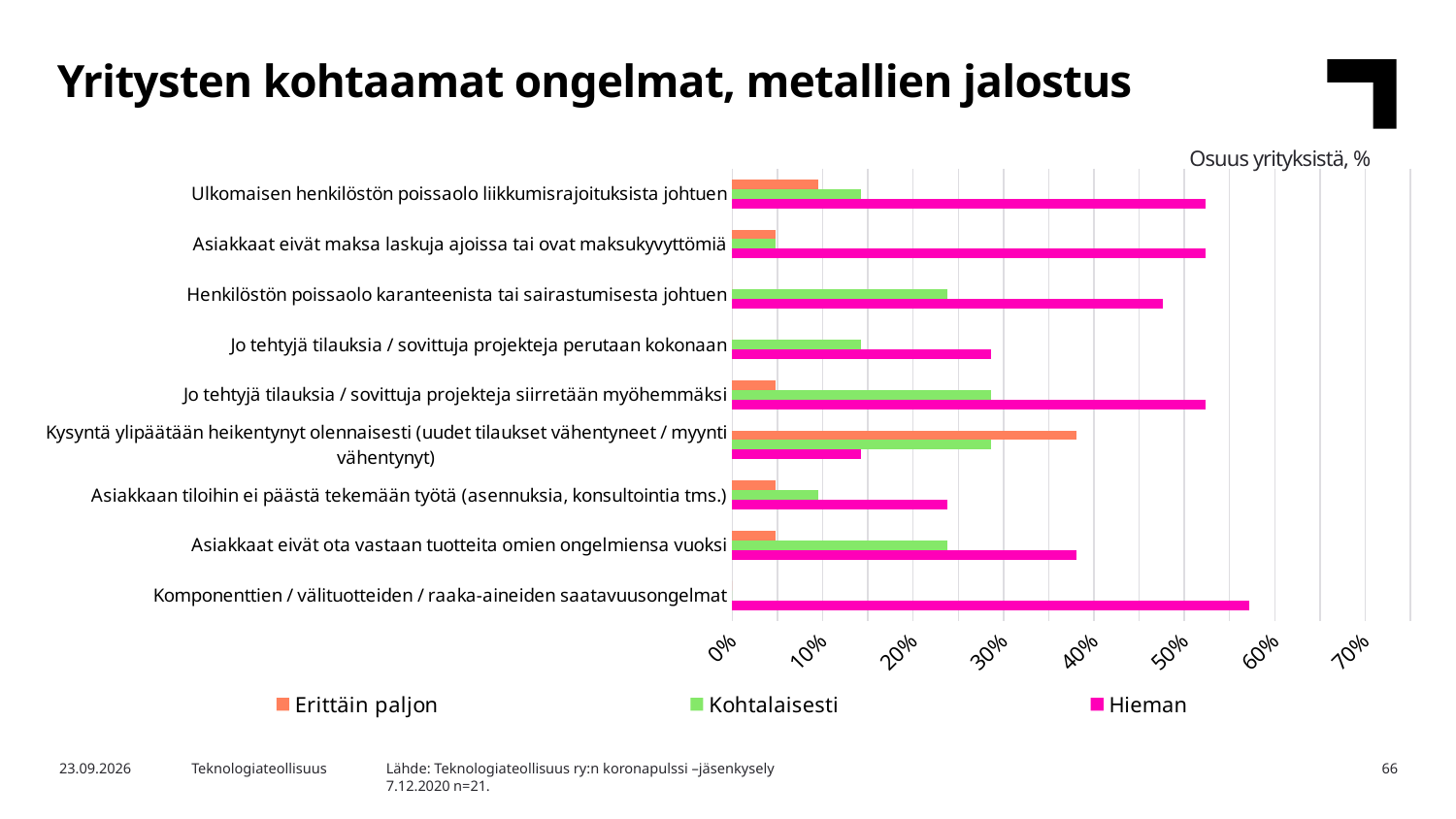
How many series does the legend list? 3 Which is larger: the 'Kohtalaisesti' value for 'Henkilöstön poissaolo karanteenista tai sairastumisesta johtuen' or for 'Asiakkaan tiloihin ei päästä tekemään työtä'? Henkilöstön poissaolo karanteenista tai sairastumisesta johtuen Is the 'Erittäin paljon' value for 'Kysyntä ylipäätään heikentynyt olennaisesti' greater or less than 30%? greater Is the 'Hieman' value for 'Komponenttien / välituotteiden / raaka-aineiden saatavuusongelmat' greater or less than 50%? greater Is the 'Hieman' value for 'Jo tehtyjä tilauksia / sovittuja projekteja perutaan kokonaan' greater or less than 40%? less What kind of chart is shown on the slide? Bar chart What colour represents the 'Hieman' series in the legend? Magenta (pink) What label is shown above the chart describing the unit of the values? Osuus yrityksistä, % Which category has the highest value for the 'Erittäin paljon' series? Kysyntä ylipäätään heikentynyt olennaisesti (uudet tilaukset vähentyneet / myynti vähentynyt) Which category has the highest value for the 'Hieman' series? Komponenttien / välituotteiden / raaka-aineiden saatavuusongelmat How many categories (problems) are plotted on the chart? 9